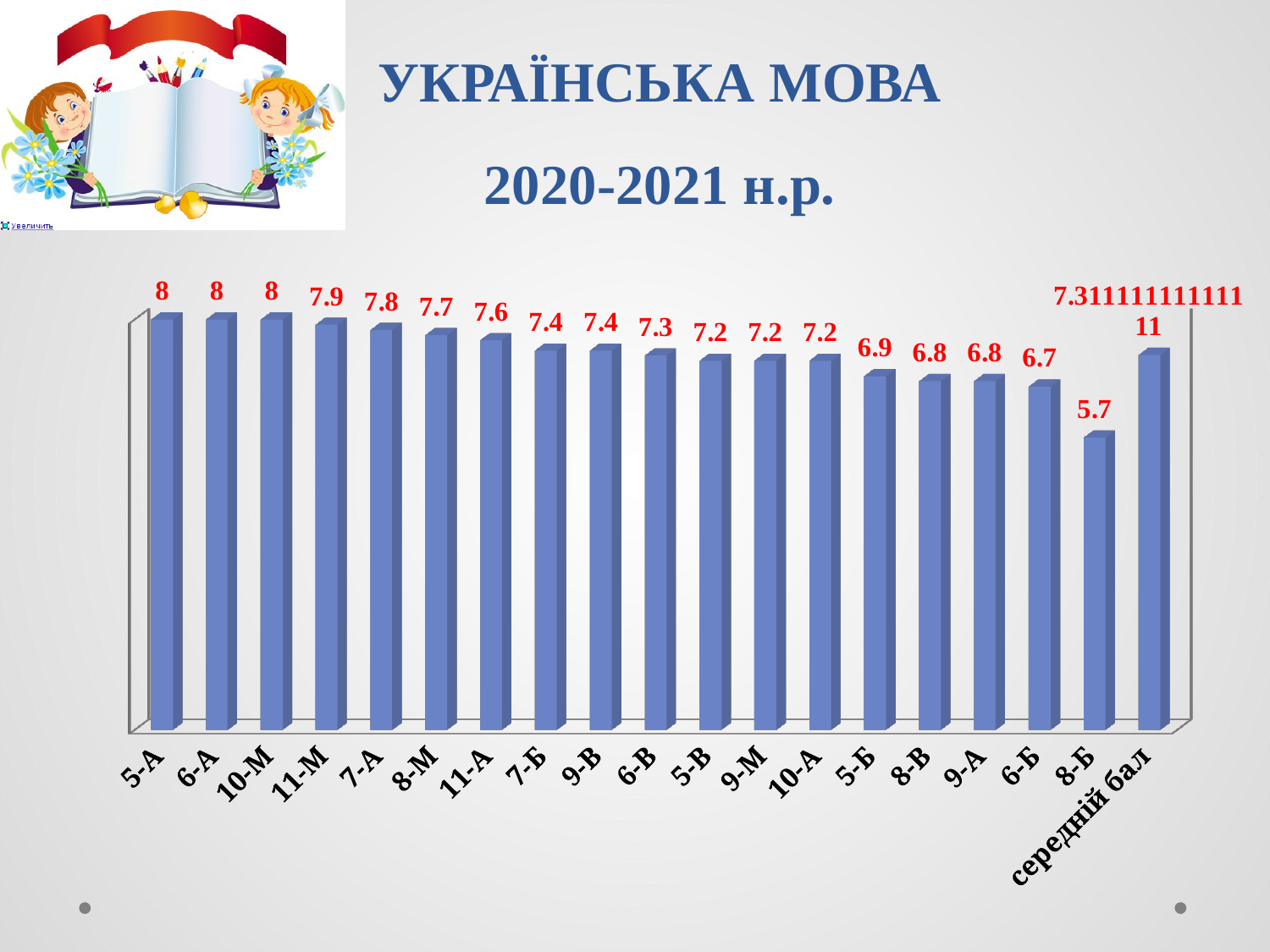
What school year is named in the slide title? 2020-2021 н.р. What is the difference between the values for 5-А and 8-Б? 2.3 Do the class values rise or fall from 5-А to 8-Б along the x axis? fall What is the difference between the values for 7-А and 6-Б? 1.1 Which has a higher value, 11-А or 9-А? 11-А What value is shown for class 5-Б? 6.9 Which class has the lowest value on the chart? 8-Б What value is shown for class 11-М? 7.9 What value is shown for class 8-Б? 5.7 What value is shown for the bar labelled 'середній бал'? 7.31111111111111 How many bars are shown on the chart? 19 What type of chart is shown on the slide? bar chart